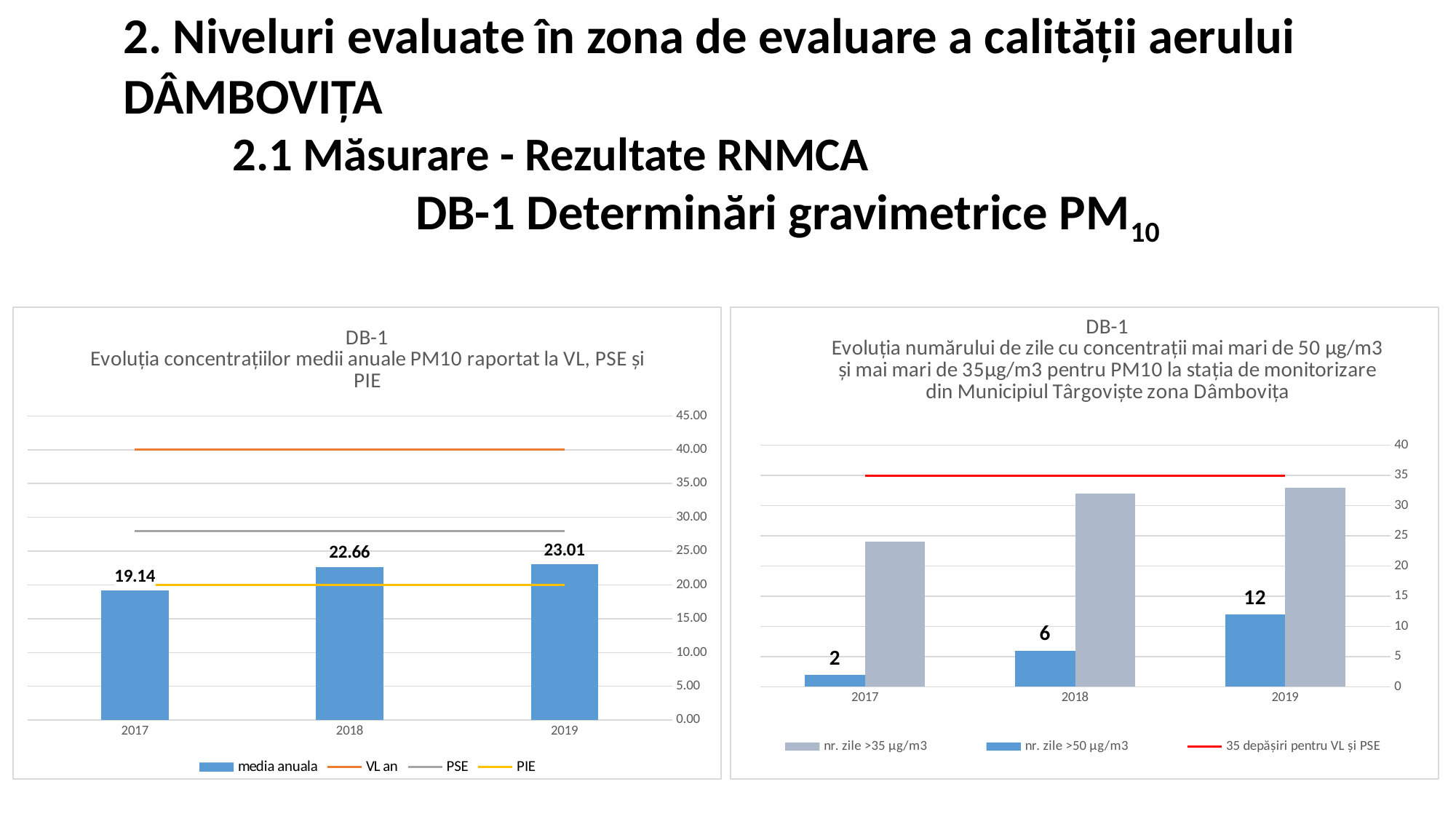
In the left chart (Evoluția concentrațiilor medii anuale PM10), does the media anuala rise or fall from 2017 to 2019? rise In the right chart (Evoluția numărului de zile), which is larger: nr. zile >35 µg/m3 for 2017 or nr. zile >35 µg/m3 for 2019? 2019 What kind of chart is the right chart (Evoluția numărului de zile)? bar chart In the left chart (Evoluția concentrațiilor medii anuale PM10), how many series does the legend list? 4 In the left chart (Evoluția concentrațiilor medii anuale PM10), what is the difference between the media anuala for 2019 and 2017? 3.87 In the right chart (Evoluția numărului de zile), what is the difference between nr. zile >50 µg/m3 for 2018 and 2017? 4 In the left chart (Evoluția concentrațiilor medii anuale PM10), what is the value of media anuala for 2017? 19.14 In the right chart (Evoluția numărului de zile), what is the value of nr. zile >50 µg/m3 for 2019? 12 In the left chart (Evoluția concentrațiilor medii anuale PM10), which year has the lowest media anuala? 2017 In the left chart (Evoluția concentrațiilor medii anuale PM10), what is the value of media anuala for 2018? 22.66 In the left chart (Evoluția concentrațiilor medii anuale PM10), which year has the highest media anuala? 2019 In the right chart (Evoluția numărului de zile), is the value of nr. zile >35 µg/m3 for 2017 greater or less than 20? greater